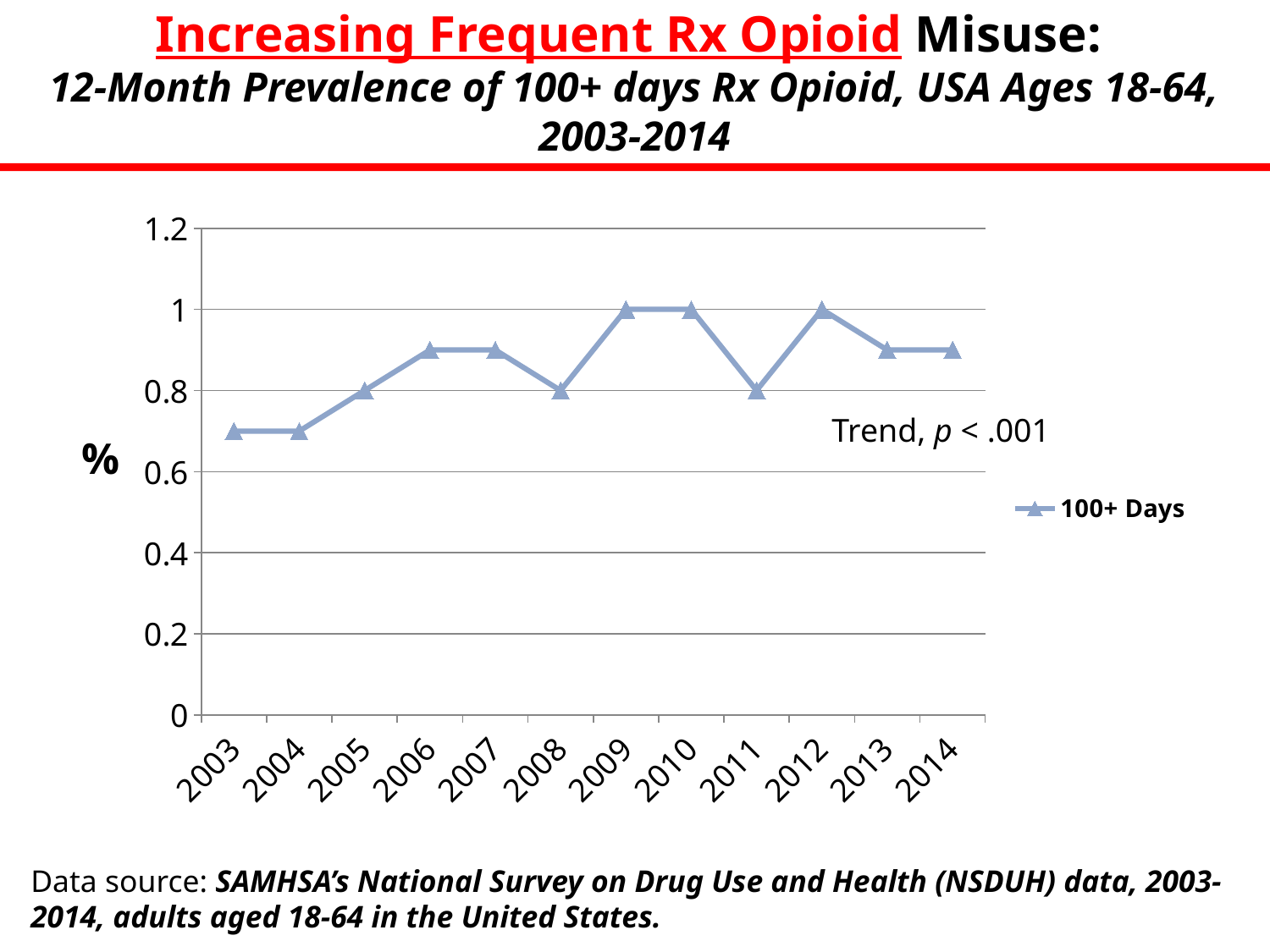
What is the highest value reached on the chart? 1 How many years (data points) are plotted on the x axis? 12 What type of chart is shown on the slide? Line chart Which year has the larger value, 2003 or 2009? 2009 Is the value for 2003 greater or less than 0.8? less What is the value for 2005? 0.8 How many series does the legend list? 1 What is the difference between the values for 2012 and 2011? 0.2 What is the value for 2009? 1 Overall, do the values rise or fall from 2003 to 2014? rise What is the value for 2011? 0.8 Is the value for 2006 greater or less than 0.8? greater